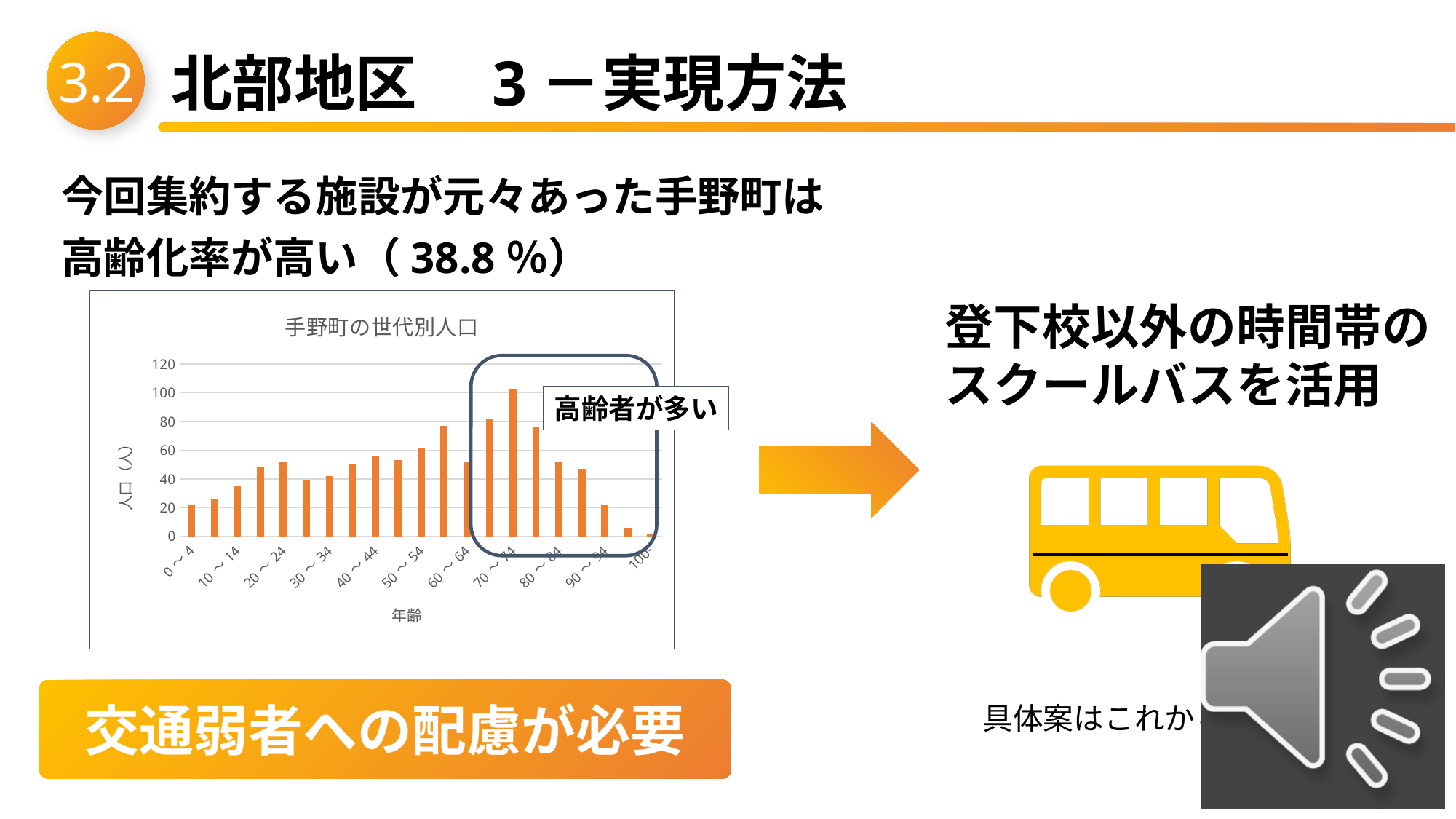
Which age group has a larger population, 70～74 or 0～4? 70～74 What is the title of the chart on the slide? 手野町の世代別人口 What kind of chart is shown on the slide? bar chart Is the population for the 100～ age group greater or less than 20? less Is the population for the 60～64 age group greater or less than 40? greater What is the label on the x axis of the chart? 年齢 Is the population for the 70～74 age group greater or less than 80? greater Which labelled age group has the lowest population in the chart? 100～ Which age group has a larger population, 40～44 or 90～94? 40～44 Which age group has the highest population in the chart? 70～74 Do the bar values rise or fall from the 70～74 age group to the 100～ age group? fall